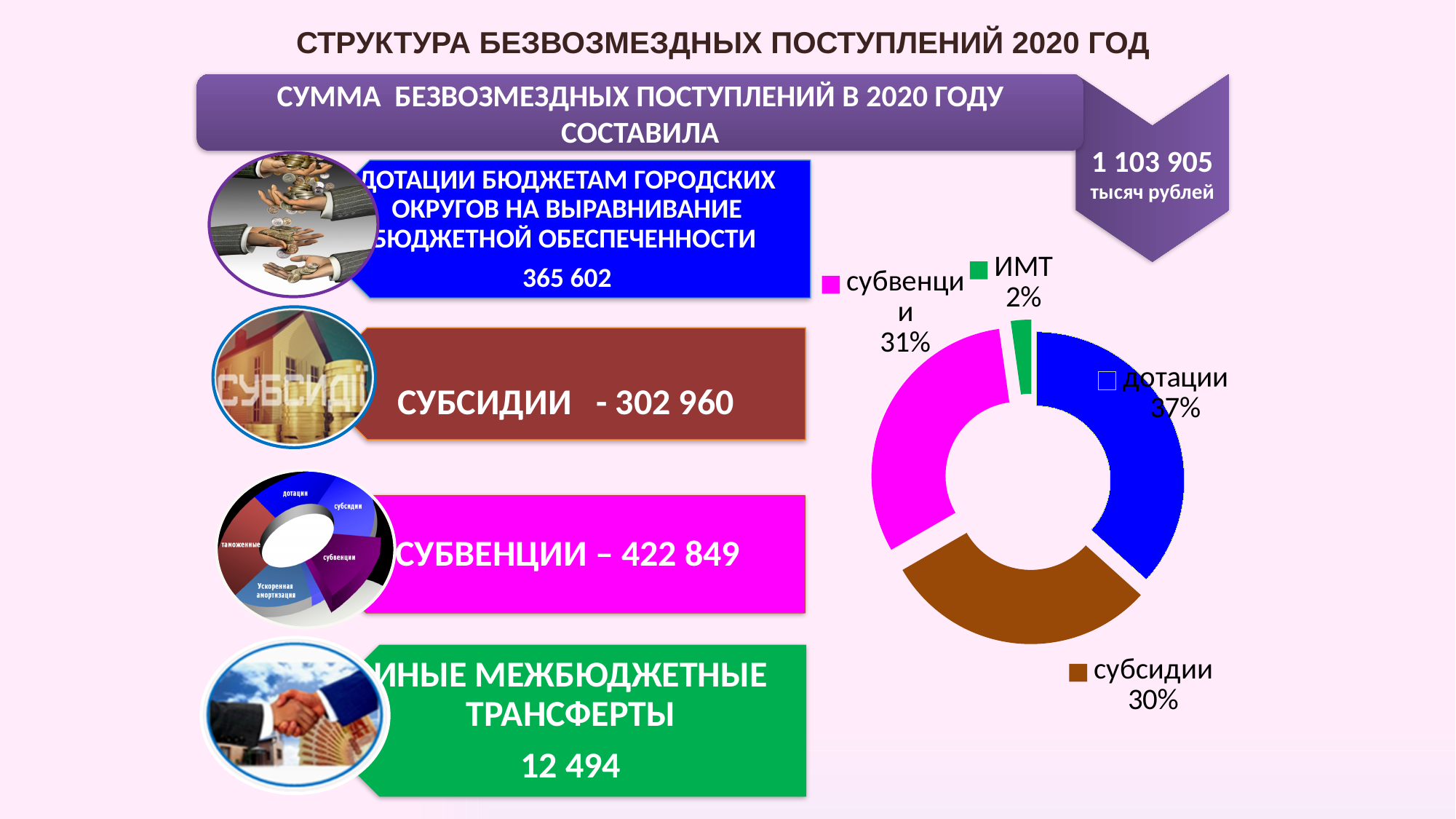
What colour is the субсидии slice in the doughnut chart? brown Which has the larger share in the doughnut chart, дотации or субсидии? дотации What share of the doughnut chart does субвенции account for? 31% What share of the doughnut chart does субсидии account for? 30% Which category has the smallest share in the doughnut chart? ИМТ What share of the doughnut chart does дотации account for? 37% What kind of chart is shown on the right side of the slide? doughnut (pie) chart How many categories are shown in the doughnut chart? 4 What colour is the ИМТ slice in the doughnut chart? green Which category has the largest share in the doughnut chart? дотации By how many percentage points does the share of дотации exceed the share of субсидии? 7